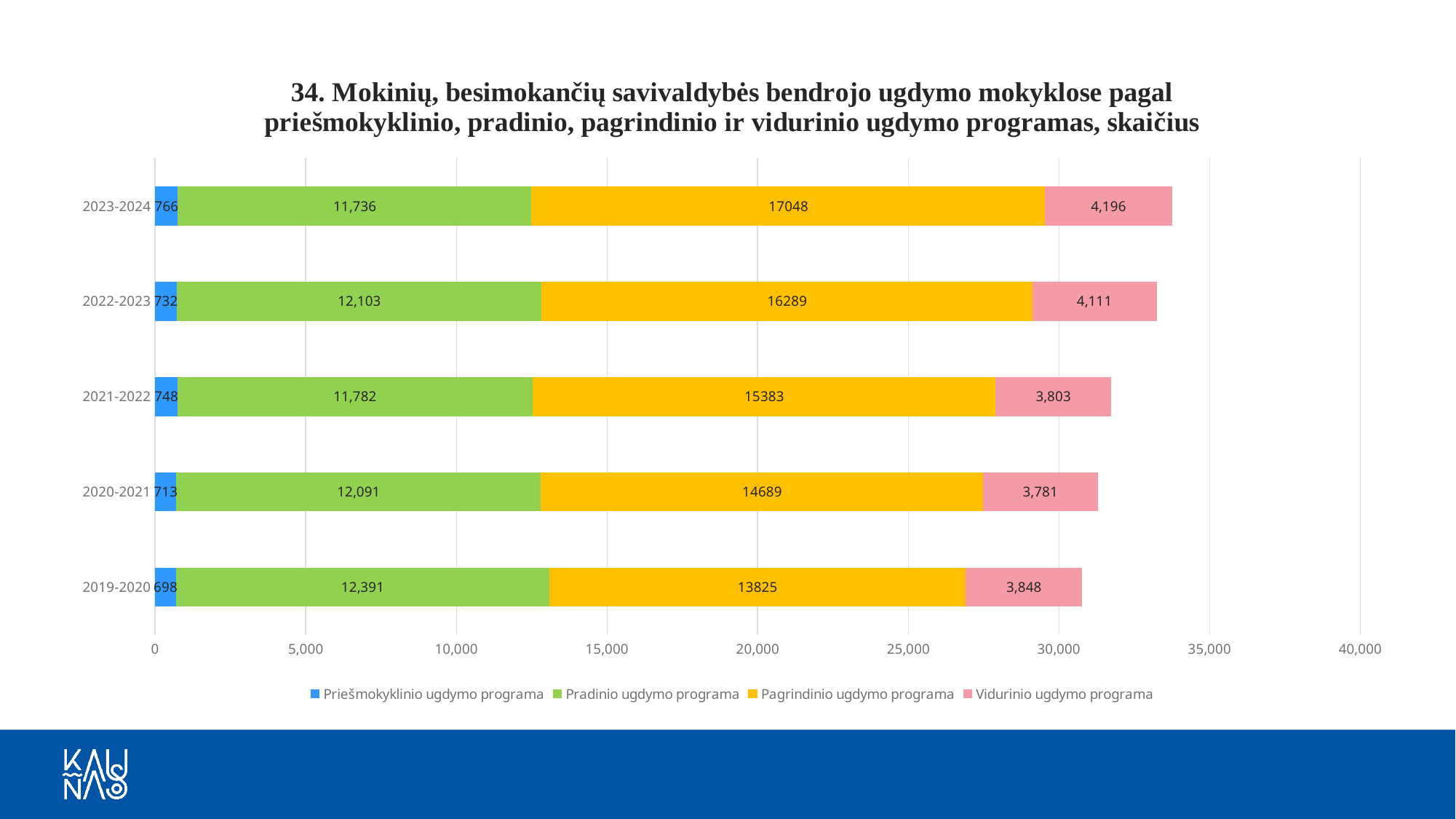
In which school year is the value for Priešmokyklinio ugdymo programa the lowest? 2019-2020 What is the total of the stacked bar for 2023-2024? 33,746 Which year has the larger value for Pradinio ugdymo programa, 2022-2023 or 2021-2022? 2022-2023 In which school year is the value for Vidurinio ugdymo programa the highest? 2023-2024 How many school years are shown on the chart? 5 What is the value for Pagrindinio ugdymo programa in 2023-2024? 17048 What is the value for Pradinio ugdymo programa in 2019-2020? 12,391 What is the difference between the Pagrindinio ugdymo programa values for 2023-2024 and 2019-2020? 3223 What is the difference between the Vidurinio ugdymo programa values for 2023-2024 and 2022-2023? 85 How many series does the legend list? 4 Does the value for Pagrindinio ugdymo programa rise or fall from 2019-2020 to 2023-2024? Rises What kind of chart is shown on the slide? Stacked bar chart